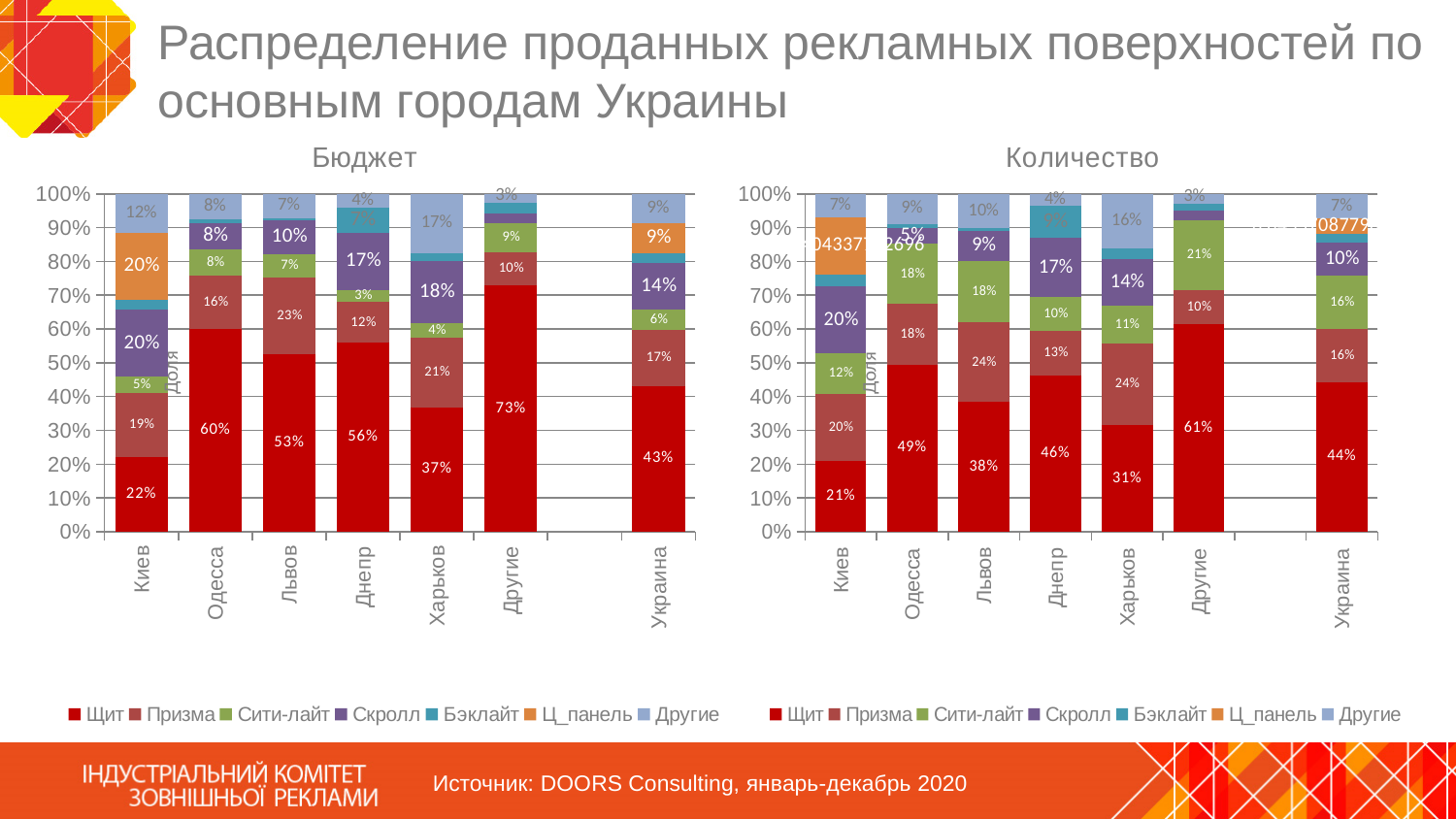
In the 'Бюджет' chart, what is the difference between the Щит share for Другие (73%) and for Харьков (37%)? 36% In the 'Количество' chart, which is larger: the Щит share for Одесса or for Днепр? Одесса What type of chart is the 'Бюджет' chart? Stacked bar chart In the 'Бюджет' chart, what is the Призма share for Львов? 23% In the 'Бюджет' chart, what is the value of the Щит segment for Одесса? 60% How many categories are shown on the x axis of the 'Количество' chart? 7 In the 'Количество' chart, what is the value of the Щит segment for Львов? 38% In the 'Бюджет' chart, which city has the highest Щит share? Другие In the 'Количество' chart, which category has the highest Щит share? Другие In the 'Бюджет' chart, which category has the lowest Щит share? Киев In the 'Количество' chart, what is the Щит share for Украина? 44% How many series does the legend of the 'Бюджет' chart list? 7